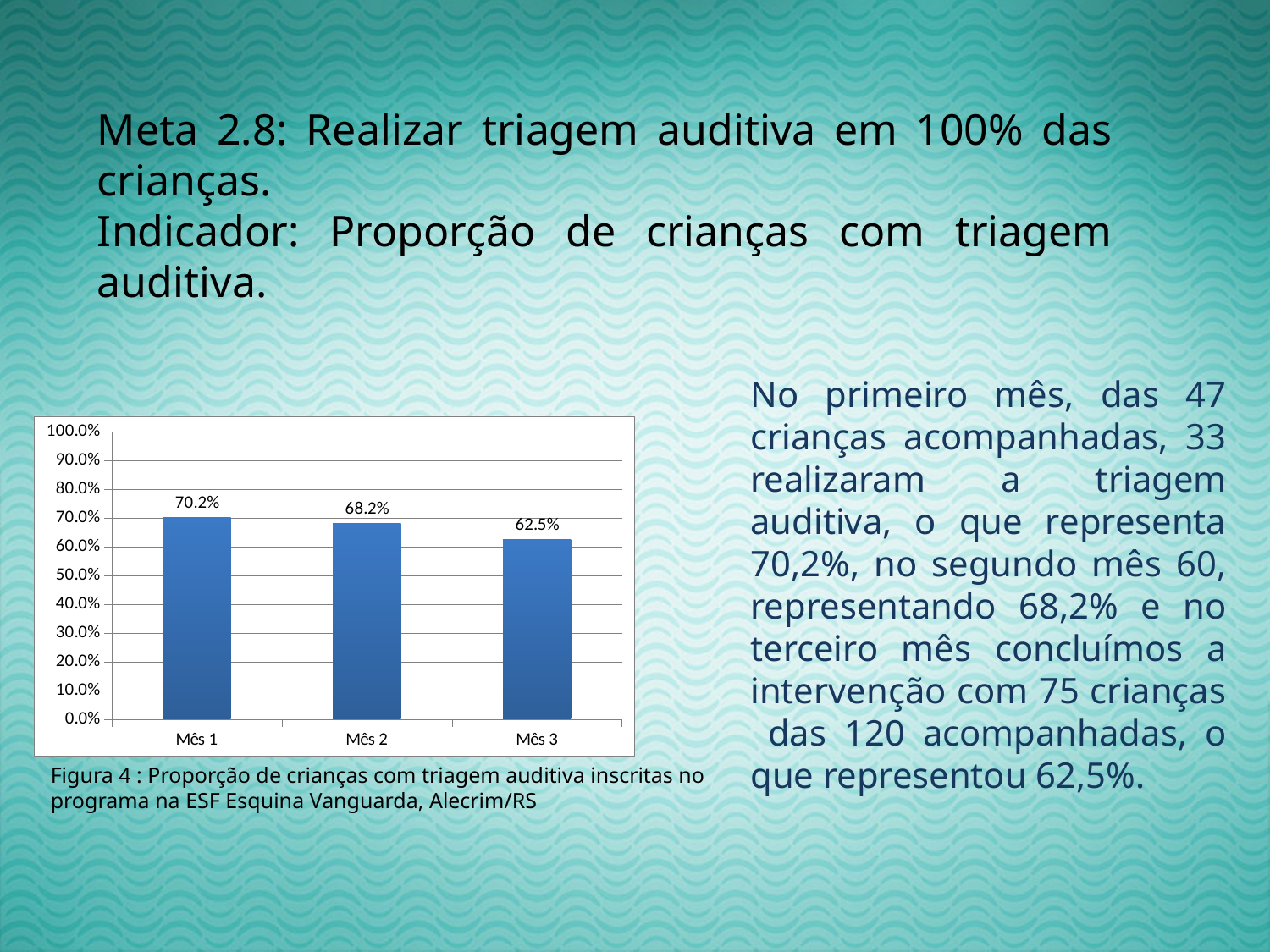
What is the difference between the values for Mês 2 and Mês 3? 5.7% Is the value for Mês 3 greater or less than 70.0%? less What is the value for Mês 2? 68.2% How many months are shown on the x axis? 3 Which month has the highest value? Mês 1 What kind of chart is shown on the slide? bar chart Which is larger, the value for Mês 1 or the value for Mês 2? Mês 1 What is the value for Mês 1? 70.2% What is the difference between the values for Mês 1 and Mês 3? 7.7% Which month has the lowest value? Mês 3 What is the value for Mês 3? 62.5% Do the values rise or fall from Mês 1 to Mês 3? fall